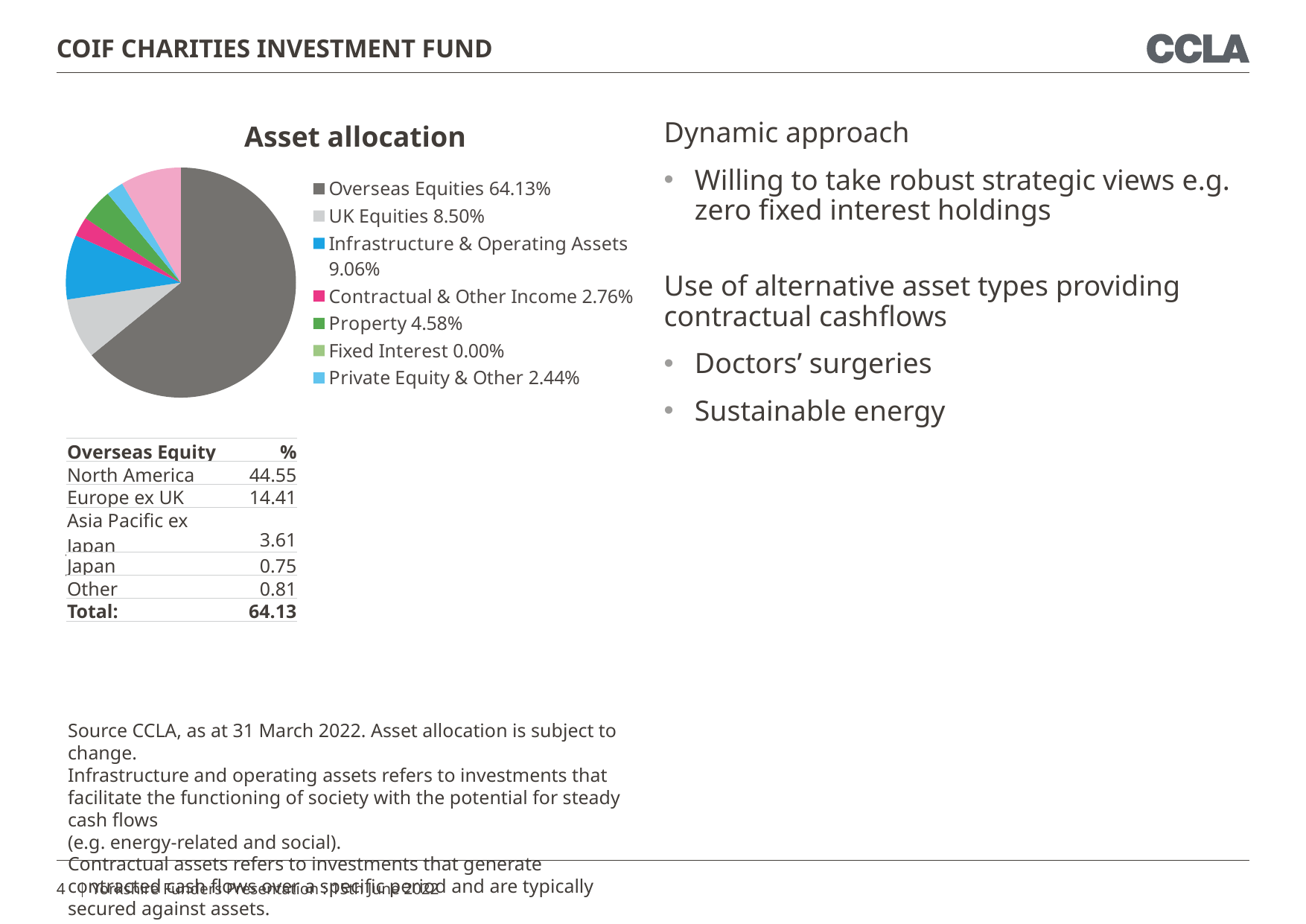
What percentage of the Asset allocation pie is Overseas Equities? 64.13% What is the value shown for UK Equities in the Asset allocation chart? 8.50% What type of chart is shown under the title "Asset allocation"? Pie chart What is the title of the chart on the slide? Asset allocation What is the value shown for Private Equity & Other in the Asset allocation chart? 2.44% What is the value shown for Property in the Asset allocation chart? 4.58% Which category has the largest share of the Asset allocation pie? Overseas Equities What is the value shown for Infrastructure & Operating Assets in the Asset allocation chart? 9.06% In the Asset allocation chart, which is larger: Contractual & Other Income or Property? Property Which category has the smallest share of the Asset allocation pie? Fixed Interest How many categories does the legend of the Asset allocation pie chart list? 7 In the Asset allocation chart, what is the difference between the Overseas Equities share and the UK Equities share? 55.63%